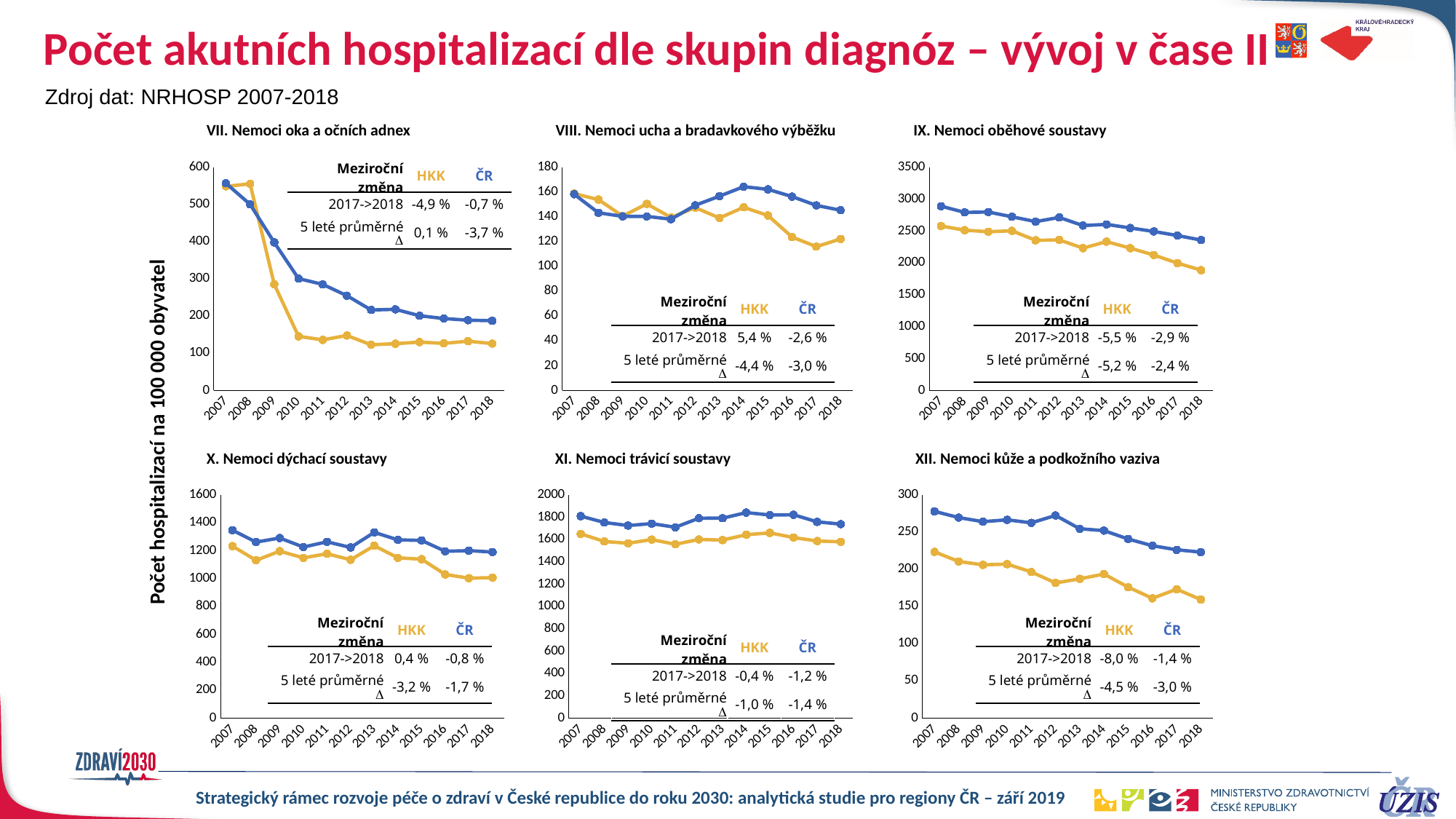
What is the title of the chart in the top-left position of the slide? VII. Nemoci oka a očních adnex In the 'X. Nemoci dýchací soustavy' chart, which series has the higher value in 2018, HKK or ČR? ČR In the 'XII. Nemoci kůže a podkožního vaziva' chart, what is the 5 leté průměrné Δ for ČR? -3,0 % In the 'VII. Nemoci oka a očních adnex' chart, is the HKK value for 2018 greater or less than 200? less In the 'X. Nemoci dýchací soustavy' chart, what is the 2017->2018 meziroční změna for HKK? 0,4 % In the 'IX. Nemoci oběhové soustavy' chart, is the HKK value for 2018 greater or less than 2000? less In the 'IX. Nemoci oběhové soustavy' chart, do the ČR values rise or fall from 2007 to 2018? fall What kind of chart is used for 'VII. Nemoci oka a očních adnex'? line chart How many years are plotted on the x axis of the 'IX. Nemoci oběhové soustavy' chart? 12 In the 'XI. Nemoci trávicí soustavy' chart, is the ČR value for 2007 greater or less than 1600? greater How many series are shown in the 'X. Nemoci dýchací soustavy' chart? 2 In the 'VII. Nemoci oka a očních adnex' chart, what is the 2017->2018 meziroční změna for HKK? -4,9 %